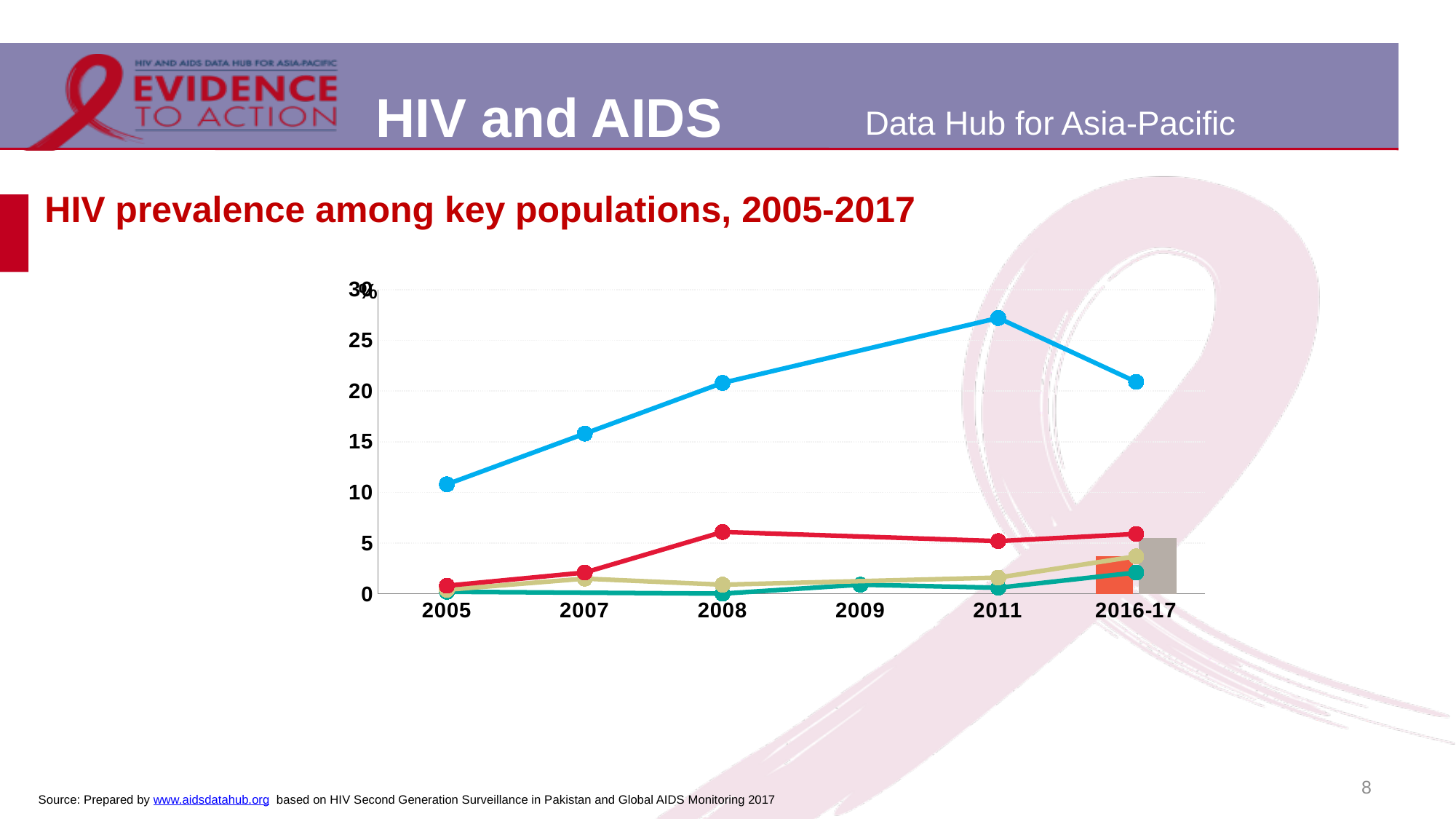
Is the value of the blue line in 2008 greater or less than 20? greater How many time points are shown on the x axis of the chart? 6 What is the title of the chart on the slide? HIV prevalence among key populations, 2005-2017 In which year does the blue line reach its highest value? 2011 Does the blue line rise or fall between 2011 and 2016-17? fall What kind of chart is shown on the slide? combination bar and line chart Is the value of the blue line in 2011 greater or less than 25? greater Does the blue line rise or fall between 2005 and 2011? rise Which line has the larger value in 2008, the blue line or the red line? the blue line Is the value of the red line in 2008 greater or less than 5? greater In which year is the blue line at its lowest value? 2005